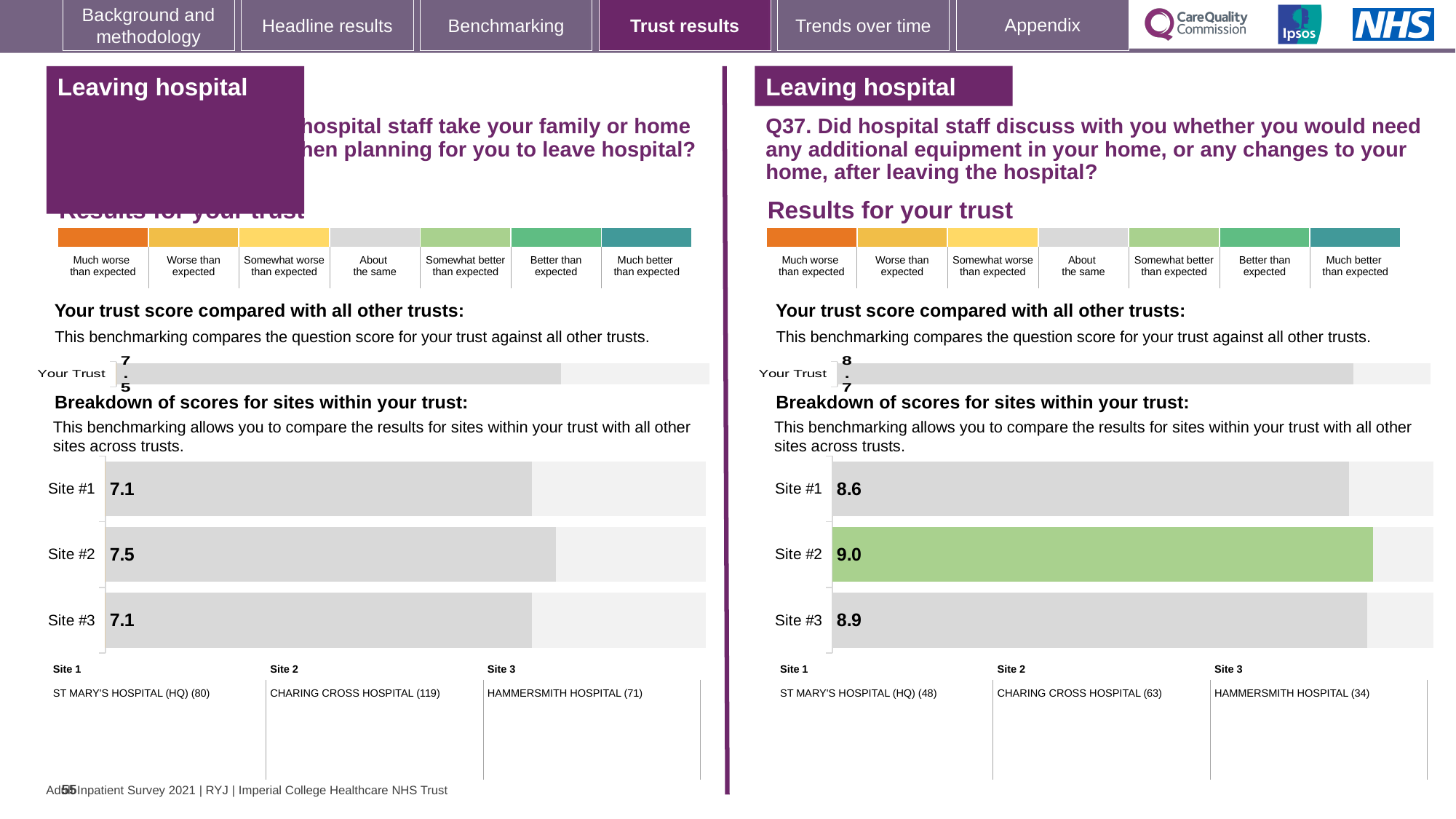
On the right-hand site breakdown chart (Q37), which site has the highest score? Site #2 On the left-hand site breakdown chart, what is the difference between the scores for Site #2 and Site #3? 0.4 On the left-hand site breakdown chart, what is the score for Site #2? 7.5 On the right-hand site breakdown chart (Q37), which site's bar is coloured green rather than grey? Site #2 On the right-hand site breakdown chart (Q37), what is the score for Site #1? 8.6 On the left-hand site breakdown chart, which site has the highest score? Site #2 What type of chart is used for the site breakdown on the right-hand side of the slide? bar chart On the right-hand site breakdown chart (Q37), is the score for Site #3 larger or smaller than the score for Site #1? larger On the right-hand site breakdown chart (Q37), what is the difference between the scores for Site #2 and Site #1? 0.4 On the right-hand 'Your trust score compared with all other trusts' chart (Q37), what is the score for Your Trust? 8.7 On the right-hand site breakdown chart (Q37), which site has the lowest score? Site #1 How many sites are shown in the left-hand site breakdown chart? 3